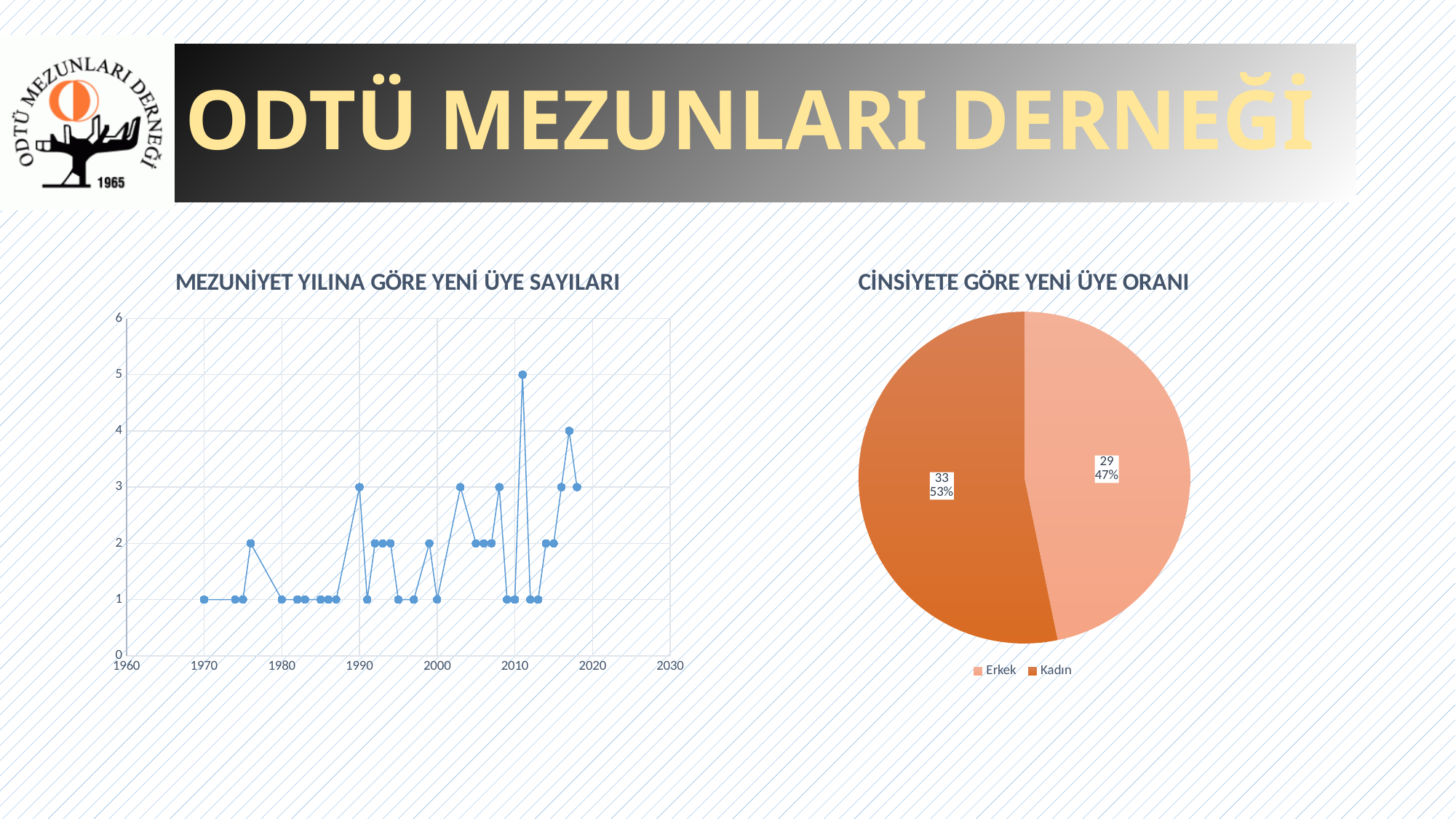
In the pie chart 'CİNSİYETE GÖRE YENİ ÜYE ORANI', what share of the pie does Erkek have? 47% What kind of chart is 'MEZUNİYET YILINA GÖRE YENİ ÜYE SAYILARI'? line chart In the chart 'MEZUNİYET YILINA GÖRE YENİ ÜYE SAYILARI', what is the highest value reached by any point? 5 In the pie chart 'CİNSİYETE GÖRE YENİ ÜYE ORANI', how many slices does the pie have? 2 In the pie chart 'CİNSİYETE GÖRE YENİ ÜYE ORANI', what is the difference between the Kadın and Erkek values? 4 In the pie chart 'CİNSİYETE GÖRE YENİ ÜYE ORANI', what is the value for Kadın? 33 What kind of chart is 'CİNSİYETE GÖRE YENİ ÜYE ORANI'? pie chart In the pie chart 'CİNSİYETE GÖRE YENİ ÜYE ORANI', what is the value for Erkek? 29 In the pie chart 'CİNSİYETE GÖRE YENİ ÜYE ORANI', what share of the pie does Kadın have? 53% In the pie chart 'CİNSİYETE GÖRE YENİ ÜYE ORANI', what are the two legend entries? Erkek, Kadın In the pie chart 'CİNSİYETE GÖRE YENİ ÜYE ORANI', which category has the larger value, Erkek or Kadın? Kadın In the chart 'MEZUNİYET YILINA GÖRE YENİ ÜYE SAYILARI', what is the lowest value reached by any point? 1